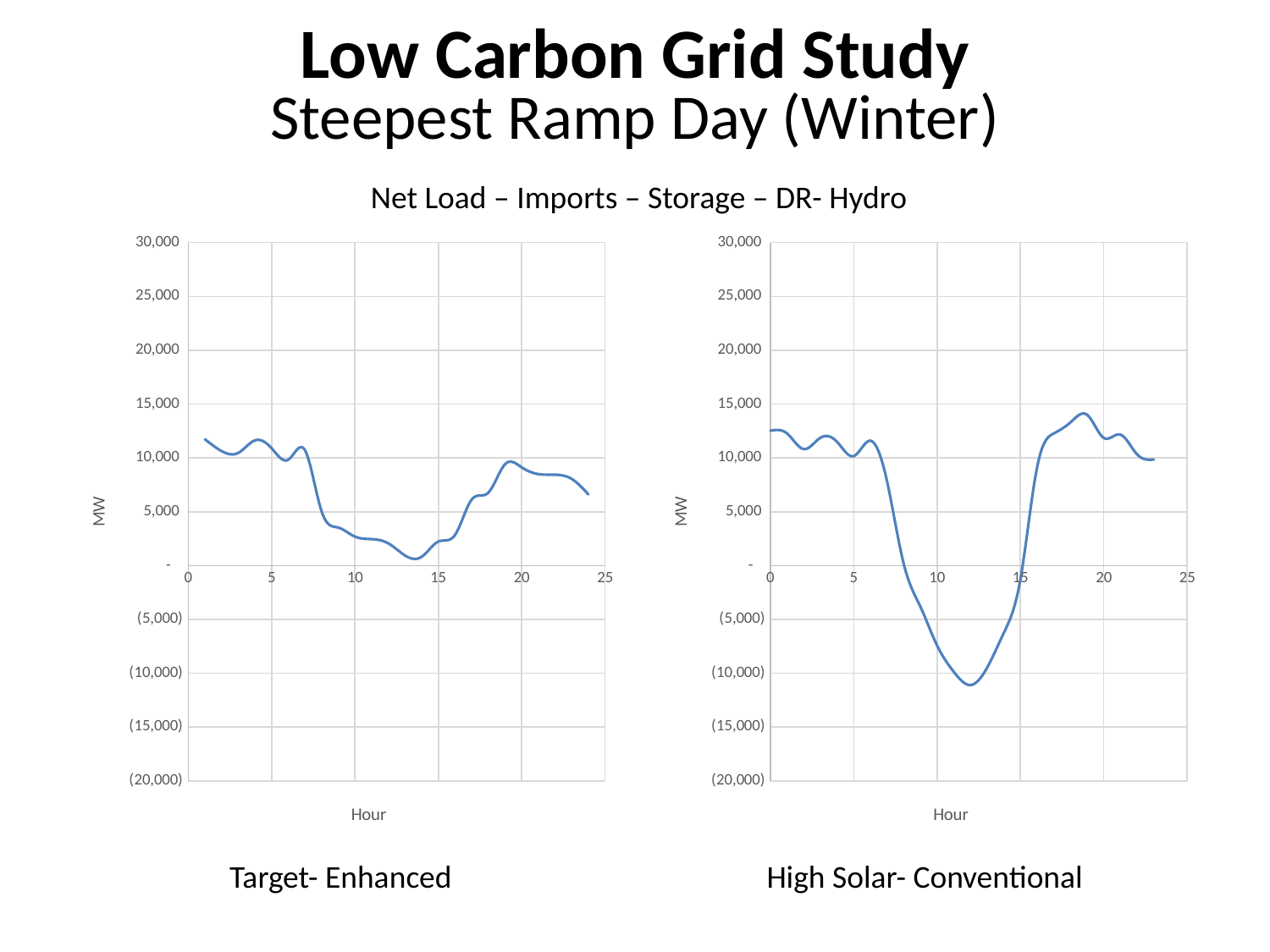
What is the y-axis label on both charts? MW In the Target- Enhanced chart, is the value at hour 1 greater or less than 10,000? greater What kind of chart is the High Solar- Conventional chart on the right? line chart In the Target- Enhanced chart, does the line rise or fall between hour 7 and hour 13? fall In the High Solar- Conventional chart, is the value at hour 19 greater or less than 10,000? greater In the High Solar- Conventional chart, is the value at hour 12 greater or less than (5,000)? less What is the x-axis label on both charts? Hour Which chart reaches a lower minimum value, Target- Enhanced or High Solar- Conventional? High Solar- Conventional Which chart's line drops below zero, Target- Enhanced or High Solar- Conventional? High Solar- Conventional What kind of chart is the Target- Enhanced chart on the left? line chart In the High Solar- Conventional chart, does the line rise or fall between hour 12 and hour 17? rise